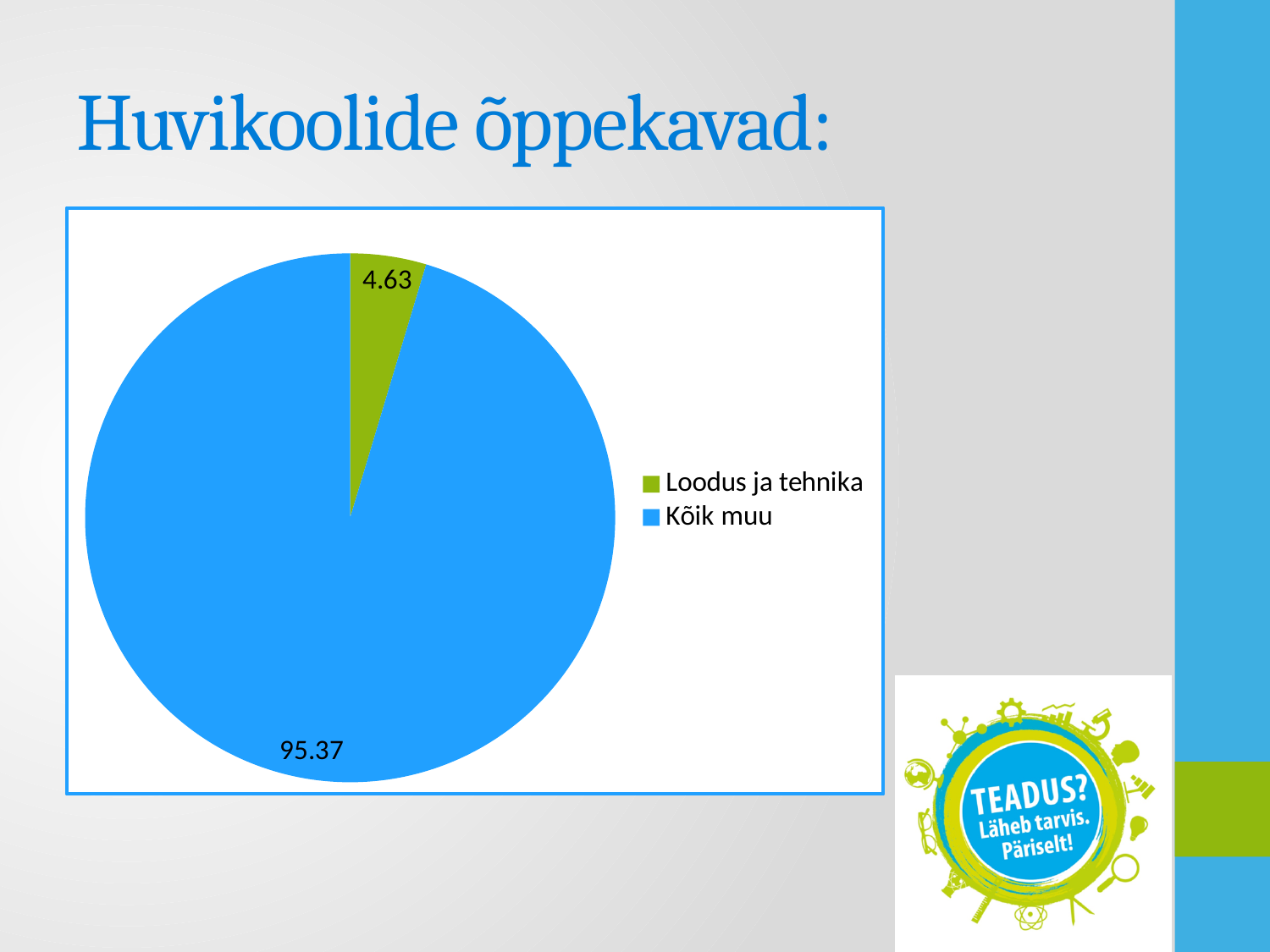
What is the total of the two slice values? 100 What is the value for Loodus ja tehnika? 4.63 How many entries does the legend list? 2 What is the difference between the values for Kõik muu and Loodus ja tehnika? 90.74 What is the value for Kõik muu? 95.37 Which slice is the smallest? Loodus ja tehnika How many slices does the pie chart have? 2 What colour is the Loodus ja tehnika slice? green Which slice is the largest? Kõik muu Which is larger, Loodus ja tehnika or Kõik muu? Kõik muu What is the title of the slide containing the chart? Huvikoolide õppekavad: What kind of chart is shown on the slide? pie chart